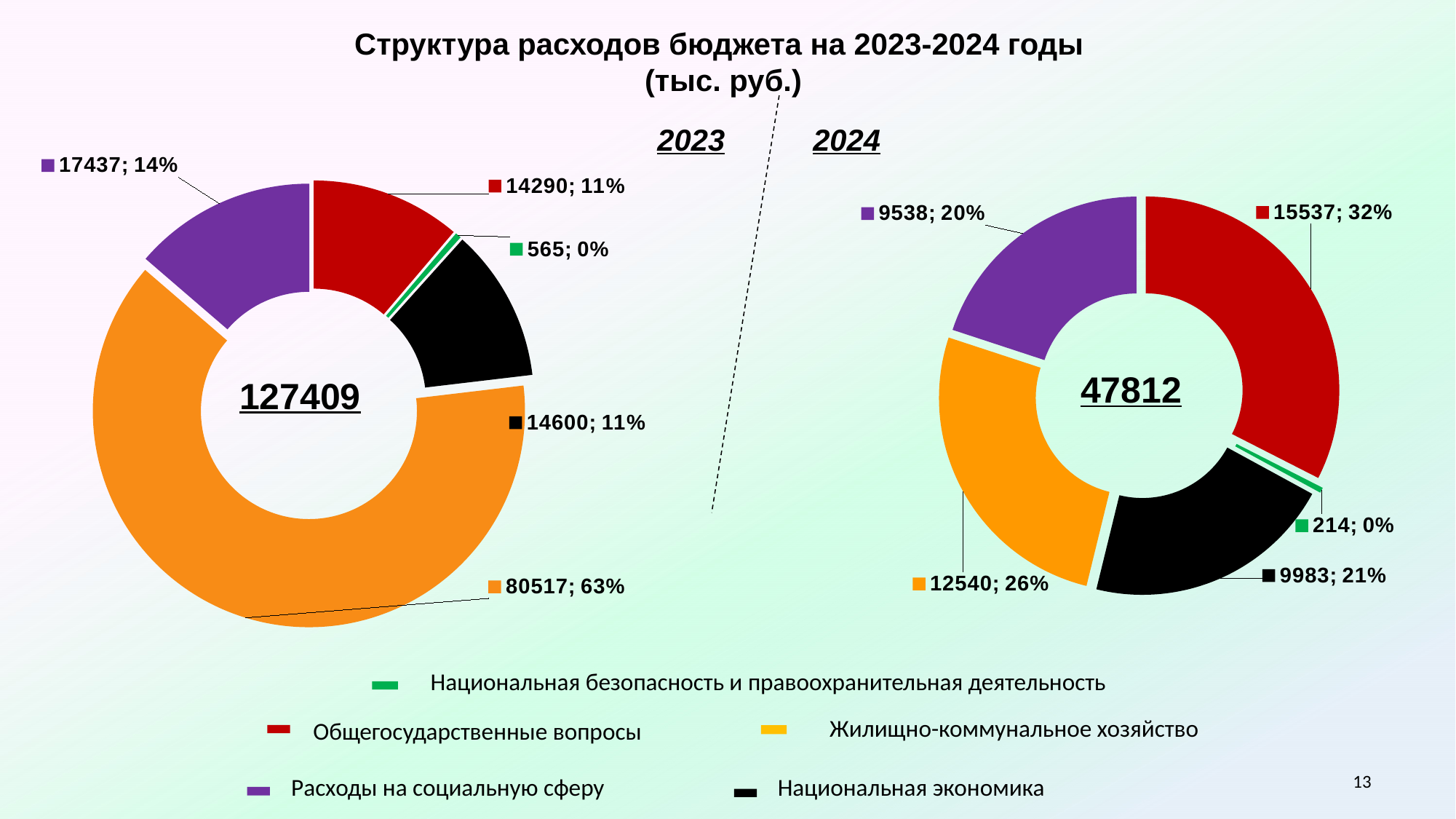
In the 2023 chart, which category has the smallest value? Национальная безопасность и правоохранительная деятельность What colour represents Национальная экономика in the legend? Black In the 2023 chart, what is the value for Жилищно-коммунальное хозяйство? 80517 In the 2024 chart, what share of the total does Национальная экономика represent? 21% How many categories does each donut chart show? 5 What type of chart is used for the 2023 and 2024 data? Donut (pie) chart In the 2024 chart, which is larger: Жилищно-коммунальное хозяйство or Расходы на социальную сферу? Жилищно-коммунальное хозяйство In the 2023 chart, what share of the total does Расходы на социальную сферу represent? 14% In the 2023 chart, what is the difference between Национальная экономика and Общегосударственные вопросы? 310 What total is shown in the centre of the 2024 chart? 47812 In the 2024 chart, what is the value for Общегосударственные вопросы? 15537 In the 2024 chart, which category has the largest value? Общегосударственные вопросы